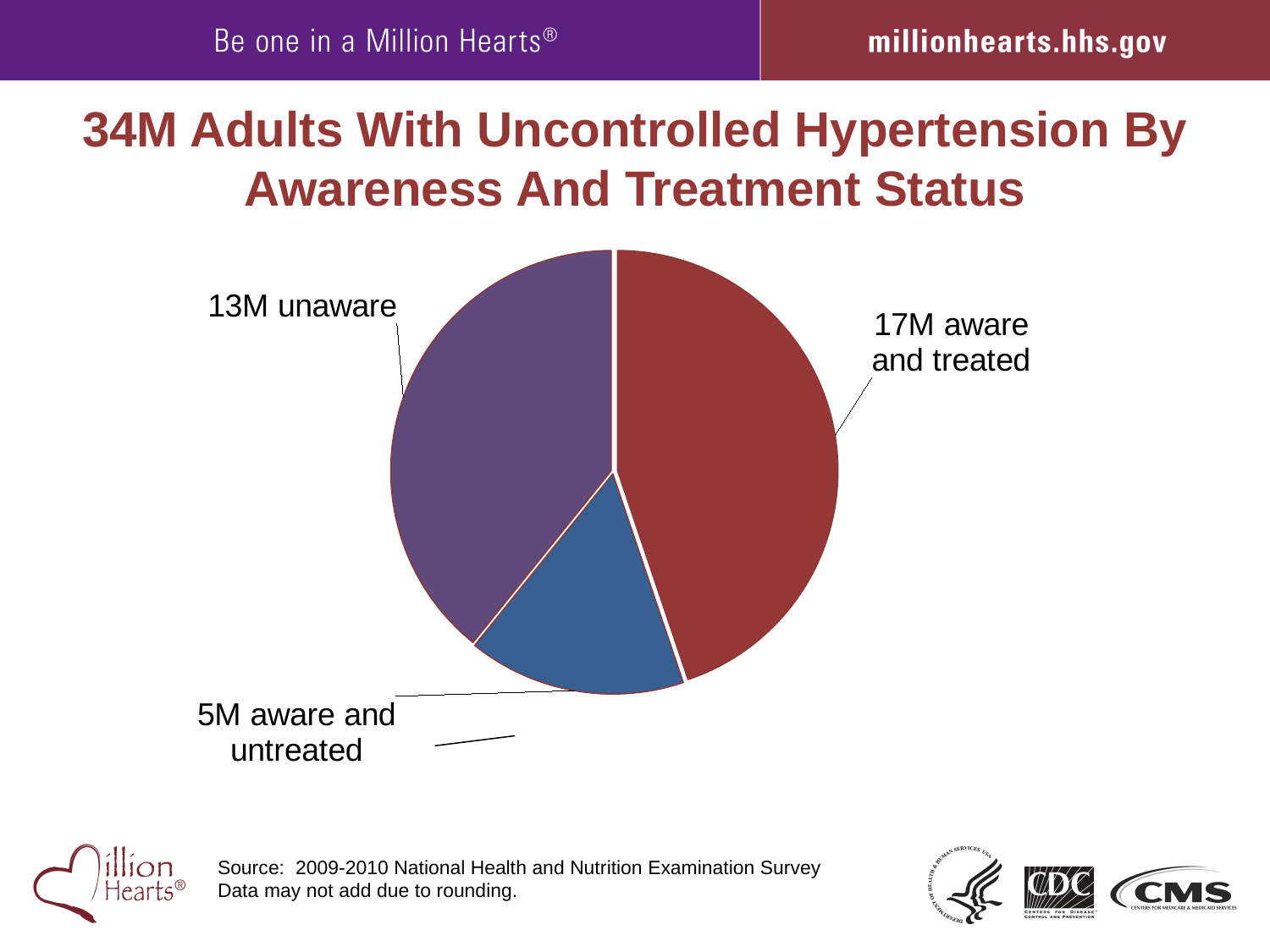
What is the difference between the number of adults unaware and the number aware and untreated? 8M How many adults are aware and treated according to the pie chart? 17M What colour is the slice for adults who are aware and untreated? Blue How many slices does the pie chart have? 3 Which category has the smallest slice of the pie chart? Aware and untreated What is the title of the chart on the slide? 34M Adults With Uncontrolled Hypertension By Awareness And Treatment Status How many adults are aware and untreated according to the pie chart? 5M What is the difference between the number of adults aware and treated and the number unaware? 4M Which category has the largest slice of the pie chart? Aware and treated What kind of chart is shown on the slide? Pie chart How many adults are unaware according to the pie chart? 13M Which is larger: the number of adults unaware or the number aware and untreated? Unaware